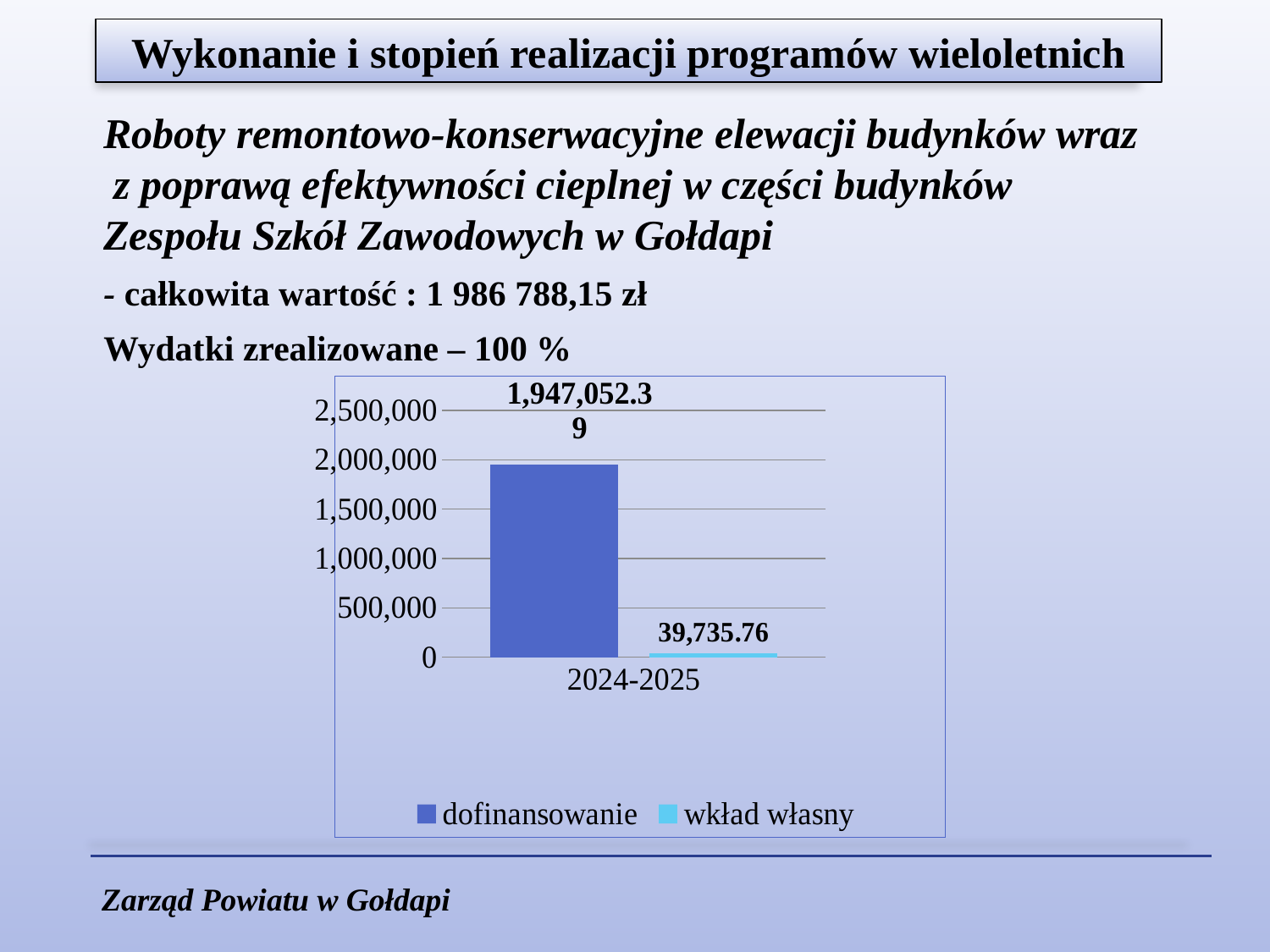
What is the sum of dofinansowanie and wkład własny for 2024-2025? 1,986,788.15 What is the value of wkład własny for 2024-2025? 39,735.76 Is the value for wkład własny greater or less than 500,000? less Which series has the lowest value in the chart? wkład własny Which series has the larger value for 2024-2025, dofinansowanie or wkład własny? dofinansowanie How many categories are shown on the x axis of the chart? 1 How many series does the legend list? 2 What colour represents wkład własny in the legend? light blue What kind of chart is shown on the slide? bar chart Is the value for dofinansowanie greater or less than 1,500,000? greater What is the difference between dofinansowanie and wkład własny for 2024-2025? 1,907,316.63 What is the value of dofinansowanie for 2024-2025? 1,947,052.39